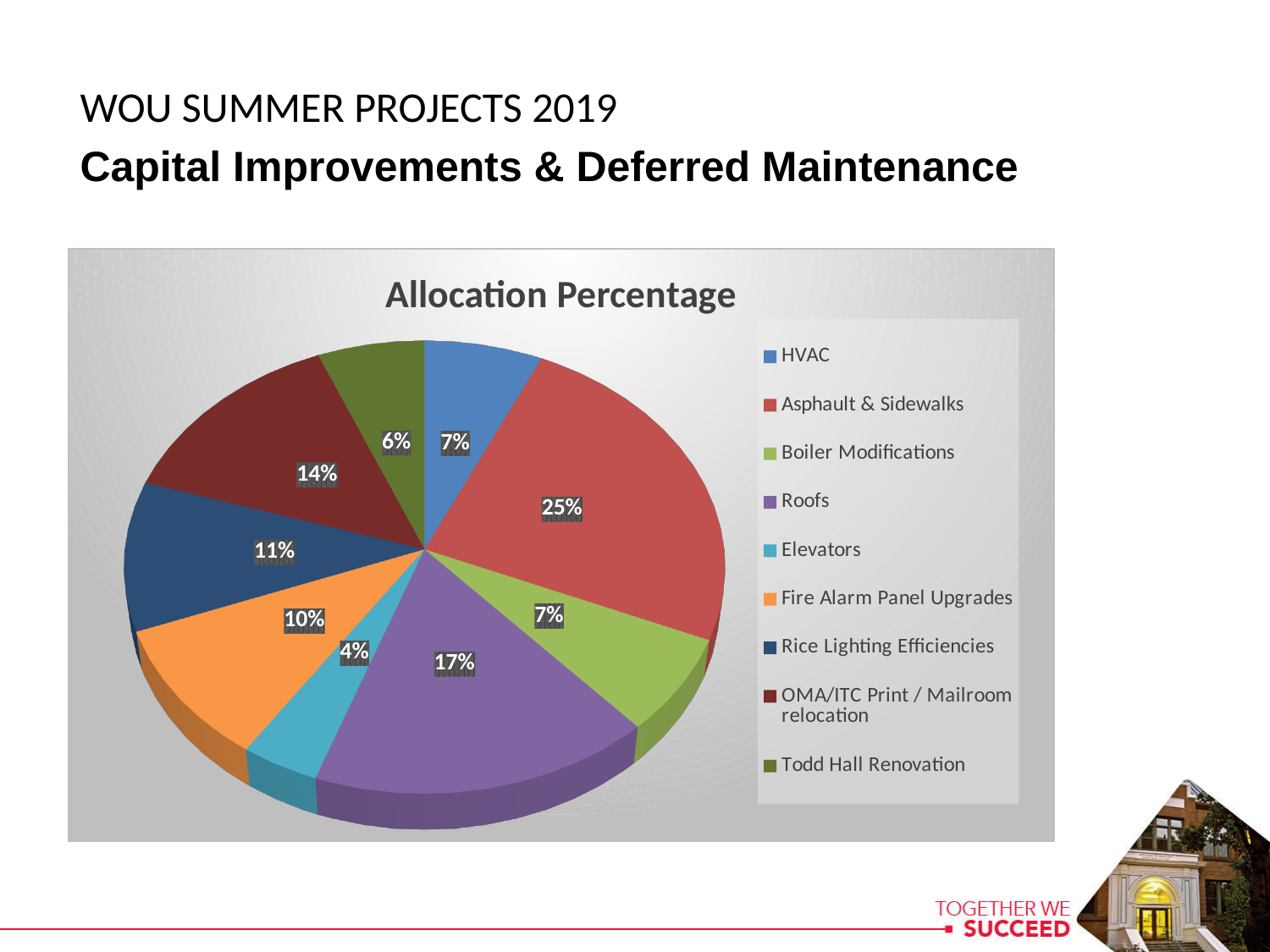
How many categories does the legend list? 9 Which has a larger share, Rice Lighting Efficiencies or Todd Hall Renovation? Rice Lighting Efficiencies What is the difference in percentage points between Roofs and Fire Alarm Panel Upgrades? 7 What percentage is allocated to Roofs? 17% What percentage is allocated to Elevators? 4% What is the title of the chart? Allocation Percentage Which category has the smallest share of the pie? Elevators What type of chart is shown on the slide? Pie chart What percentage is allocated to OMA/ITC Print / Mailroom relocation? 14% Which category has the largest share of the pie? Asphault & Sidewalks What percentage is allocated to Asphault & Sidewalks? 25% What colour is the slice for Fire Alarm Panel Upgrades? Orange